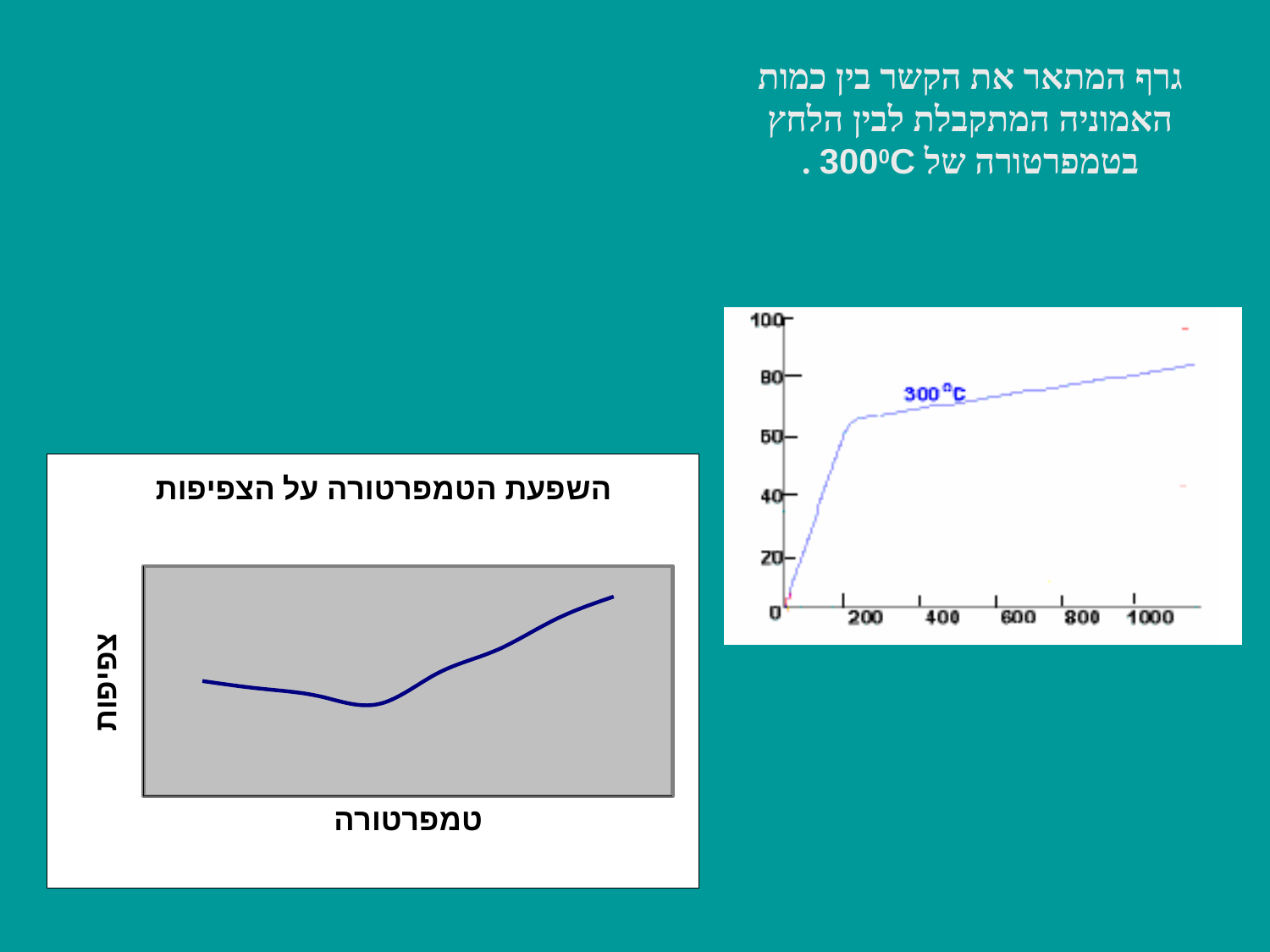
On the chart on the right, what is the highest tick value shown on the y axis? 100 On the chart on the left, is the value at the right end of the line higher or lower than the value at the left end? higher What kind of chart is the chart on the right side of the slide? line chart On the chart on the right, is the value of the line at x = 200 greater or less than 40? greater On the chart on the left, what is the label of the y axis? צפיפות On the chart on the right, is the value of the line at x = 600 greater or less than 60? greater On the chart on the left, does the line first fall and then rise, or first rise and then fall, as temperature increases? first falls and then rises On the chart on the right, is the value of the line at x = 400 greater or less than 80? less On the chart on the right, does the line rise or fall as x increases from 0 to 1000? rises On the chart on the right, what temperature label is written next to the curve? 300°C What kind of chart is the chart on the left side of the slide, titled 'השפעת הטמפרטורה על הצפיפות'? line chart